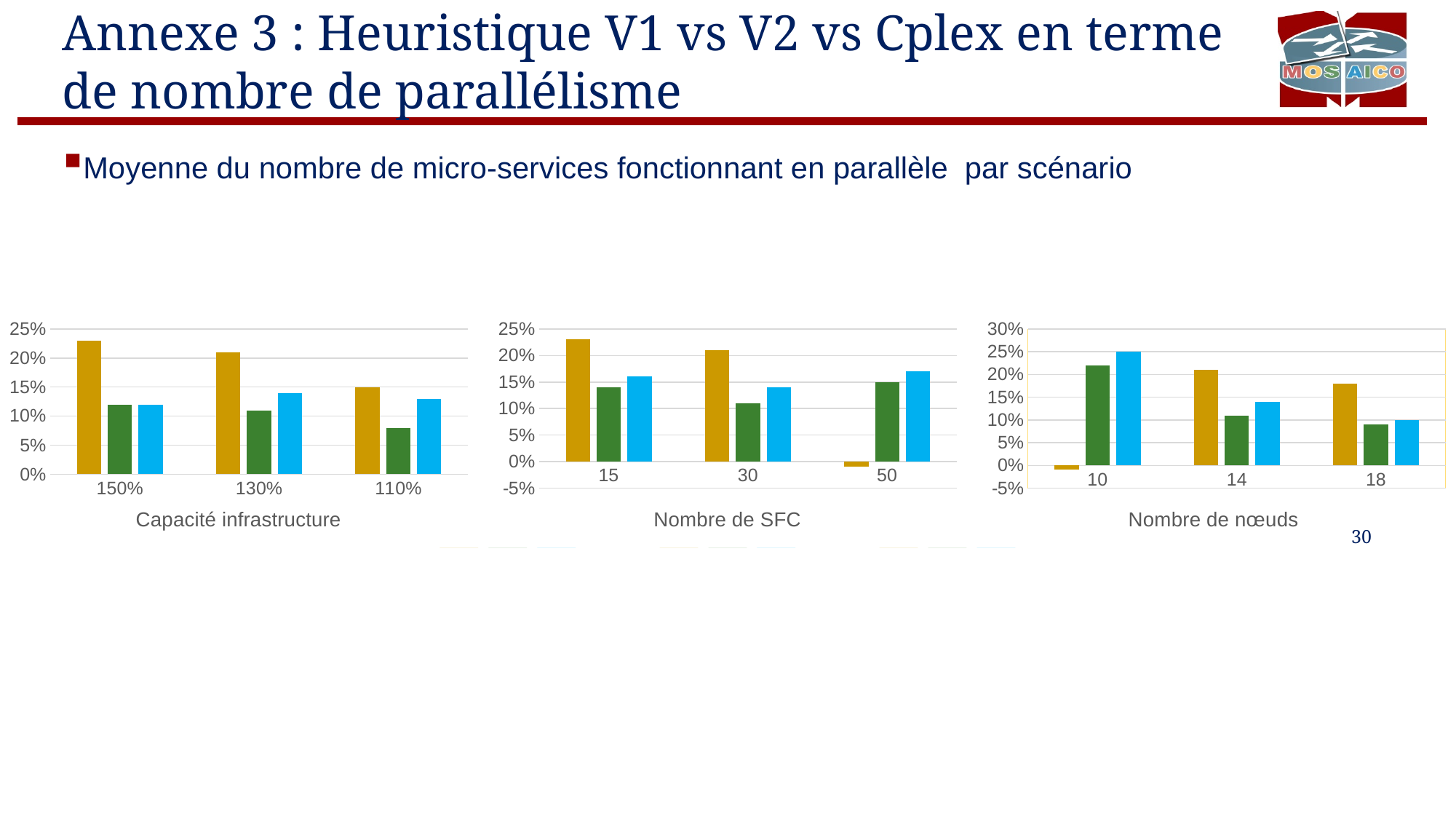
In the 'Nombre de SFC' chart, which category has the tallest gold bar? 15 In the 'Nombre de SFC' chart, is the gold bar for 50 greater or less than 0%? less In the 'Nombre de nœuds' chart, is the blue bar for 10 greater or less than 20%? greater How many charts are shown on the slide? 3 In the 'Nombre de nœuds' chart, which category has the tallest blue bar? 10 In the 'Capacité infrastructure' chart, is the gold bar for 150% greater or less than 20%? greater In the 'Nombre de nœuds' chart, do the green bars rise or fall going from 10 to 18? fall In the 'Capacité infrastructure' chart, do the gold bars rise or fall going from 150% to 110%? fall How many categories are shown on the x axis of the 'Nombre de SFC' chart? 3 In the 'Nombre de SFC' chart, for category 50, which is larger: the green bar or the blue bar? the blue bar What kind of chart is the 'Capacité infrastructure' chart? bar chart